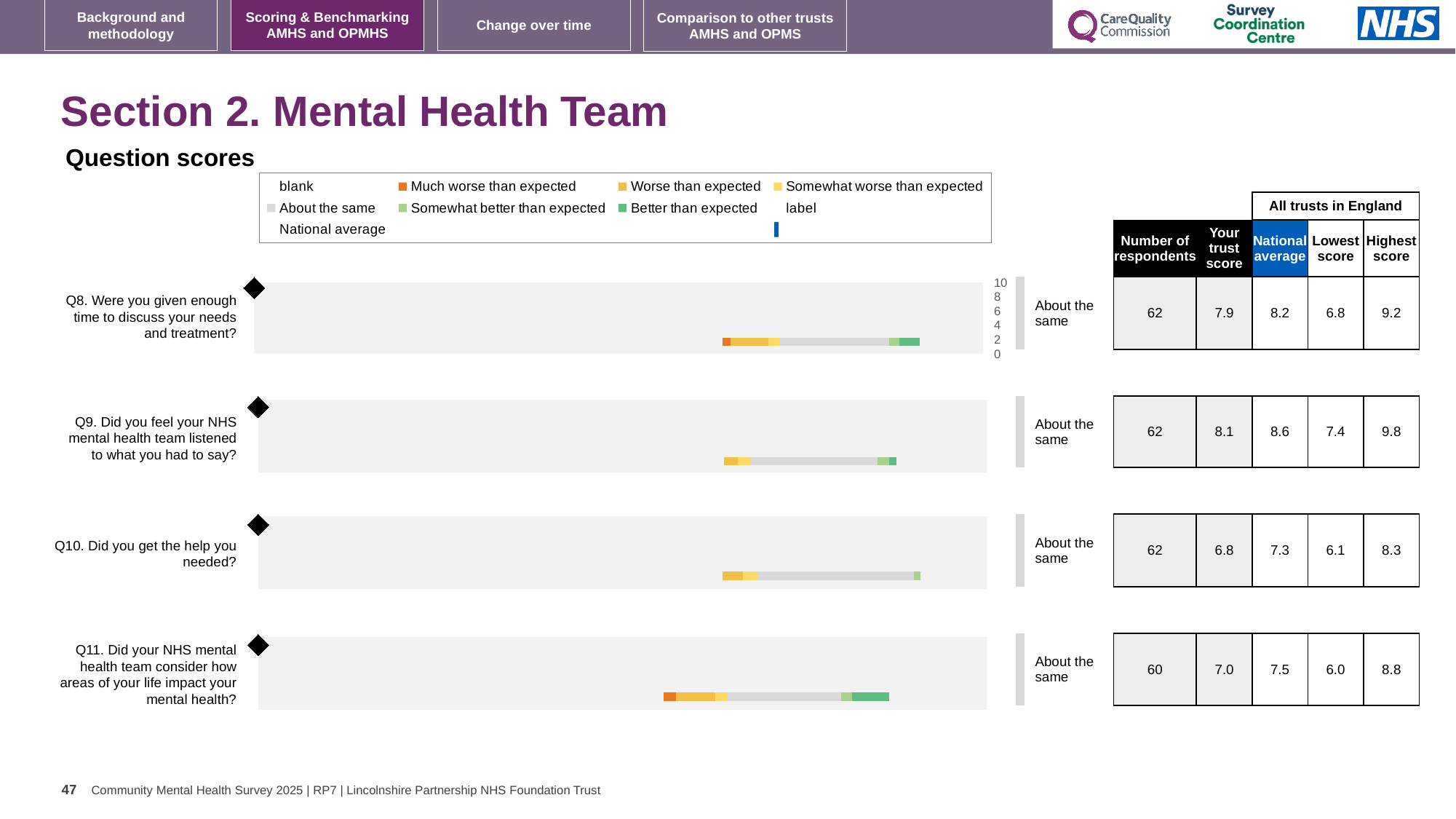
For Q8, what is the difference between the national average and the trust score? 0.3 Which question has the highest 'Your trust score' on the slide? Q9 What is the 'Your trust score' shown for Q8 (Were you given enough time to discuss your needs and treatment)? 7.9 How many respondents are shown for Q11 (Did your NHS mental health team consider how areas of your life impact your mental health)? 60 What benchmark category label is shown next to the Q10 bar? About the same What is the highest score among all trusts in England shown for Q10 (Did you get the help you needed)? 8.3 What kind of chart is used to show the question scores for Q8 to Q11? bar chart Which question has the lowest 'Your trust score' on the slide? Q10 What is the national average shown for Q9 (Did you feel your NHS mental health team listened to what you had to say)? 8.6 What does the blue marker in the legend represent? National average For Q11, which is larger: the trust score or the national average? National average How many questions (Q8 to Q11) have a score bar plotted on the slide? 4